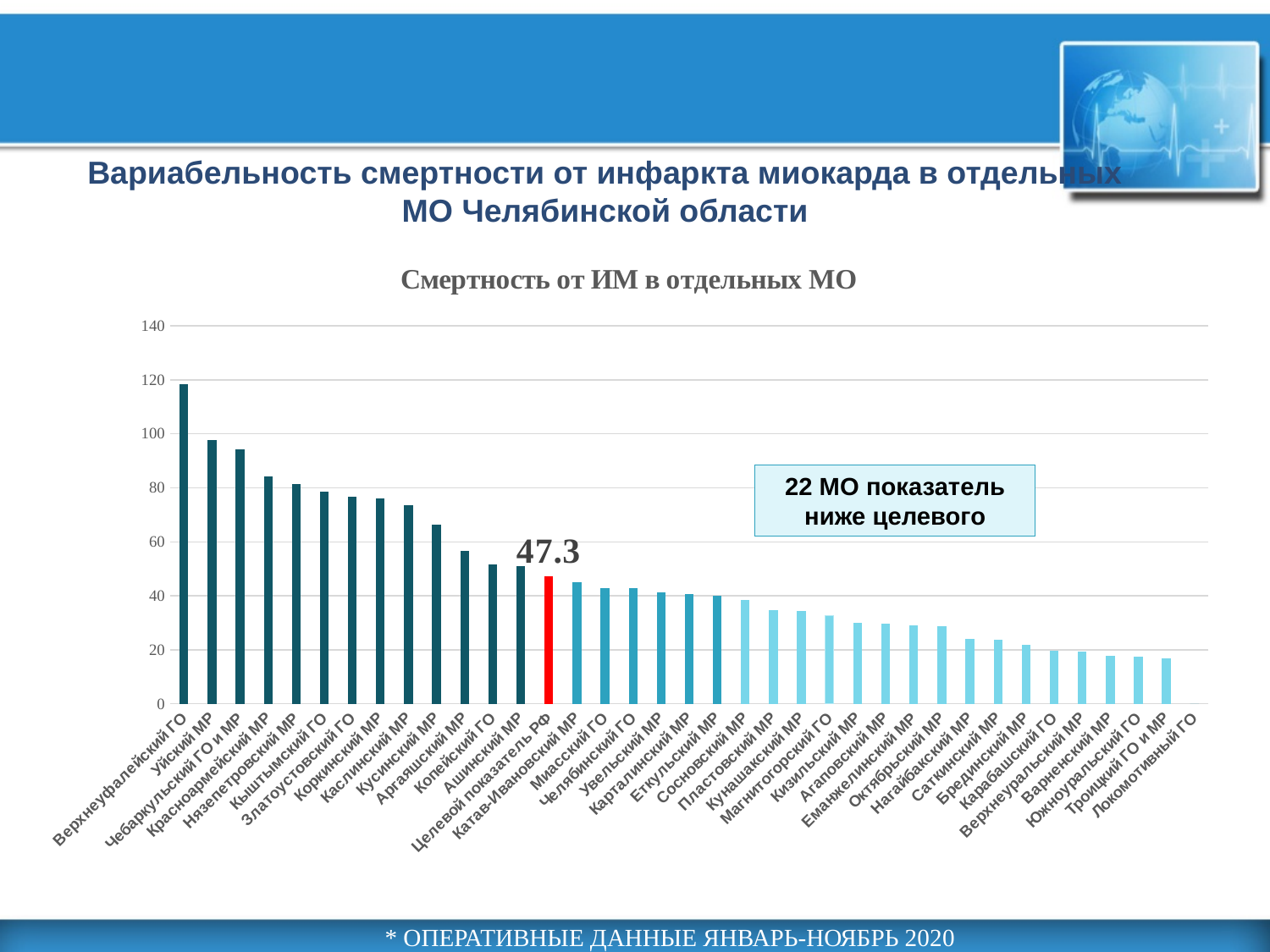
What is the title of the chart? Смертность от ИМ в отдельных МО Is the value for Локомотивный ГО greater or less than 20? less Which is larger, the value for Целевой показатель РФ or the value for Саткинский МР? Целевой показатель РФ Which category has the highest value? Верхнеуфалейский ГО Is the value for Верхнеуфалейский ГО greater or less than 100? greater What is the value shown for Целевой показатель РФ? 47.3 What kind of chart is shown? bar chart Do the values rise or fall from left to right along the x axis? fall Which is larger, the value for Уйский МР or the value for Копейский ГО? Уйский МР What colour is the bar for Целевой показатель РФ? red Is the value for Магнитогорский ГО greater or less than 40? less